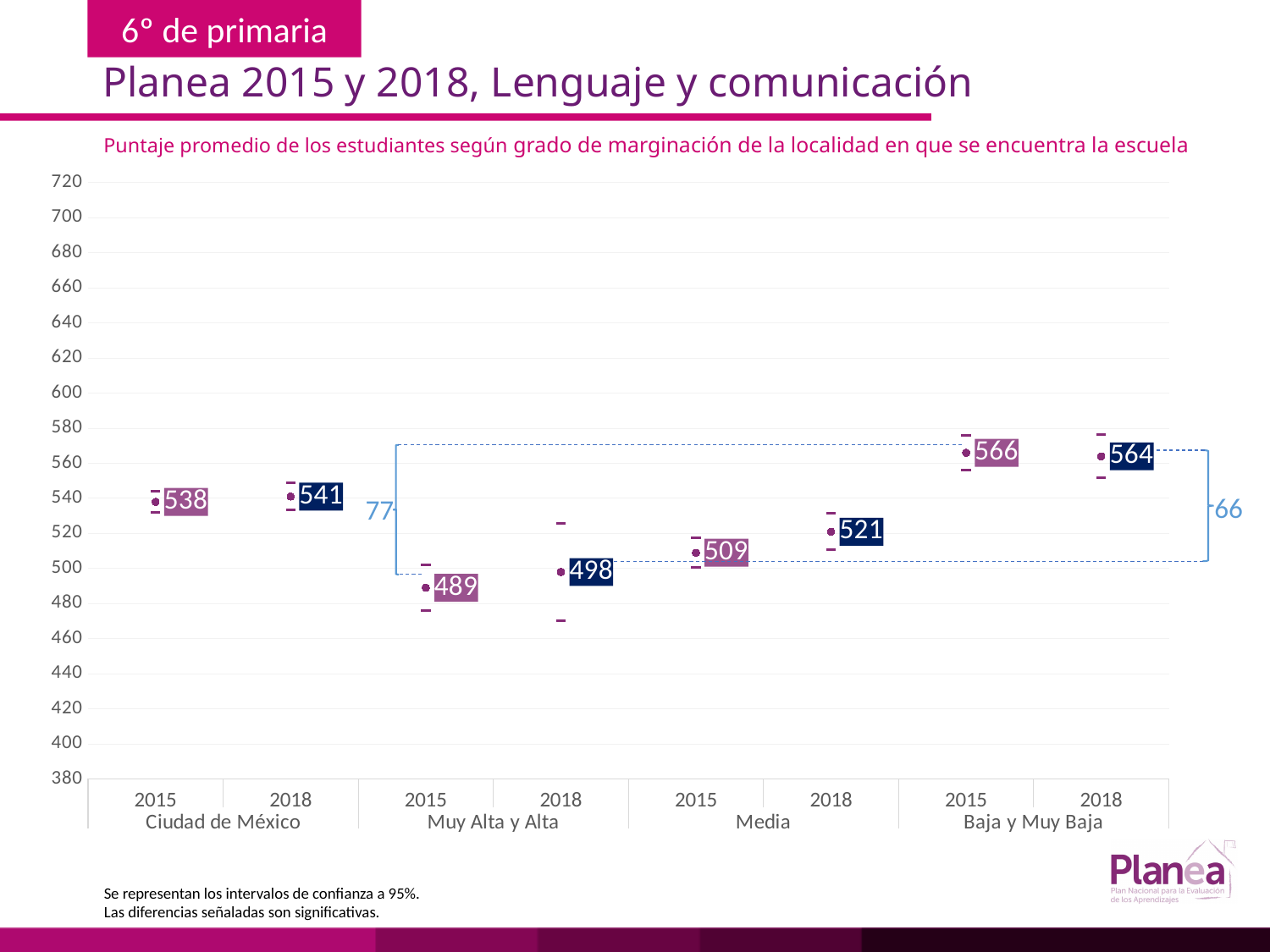
What is the subtitle of the chart? Puntaje promedio de los estudiantes según grado de marginación de la localidad en que se encuentra la escuela What is the difference between the 2015 scores of Baja y Muy Baja and Muy Alta y Alta? 77 What is the average score for Muy Alta y Alta in 2018? 498 What is the average score for Media in 2018? 521 Which group and year has the highest average score on the chart? Baja y Muy Baja, 2015 What is the average score for Baja y Muy Baja in 2015? 566 Which group and year has the lowest average score on the chart? Muy Alta y Alta, 2015 Which is larger, the 2018 score for Ciudad de México or the 2018 score for Media? Ciudad de México (541) What is the difference between the 2018 and 2015 scores for Media? 12 Is the 2015 score for Muy Alta y Alta greater or less than 500? less How many marginalization groups are shown on the x axis? 4 What is the average score for Ciudad de México in 2015? 538